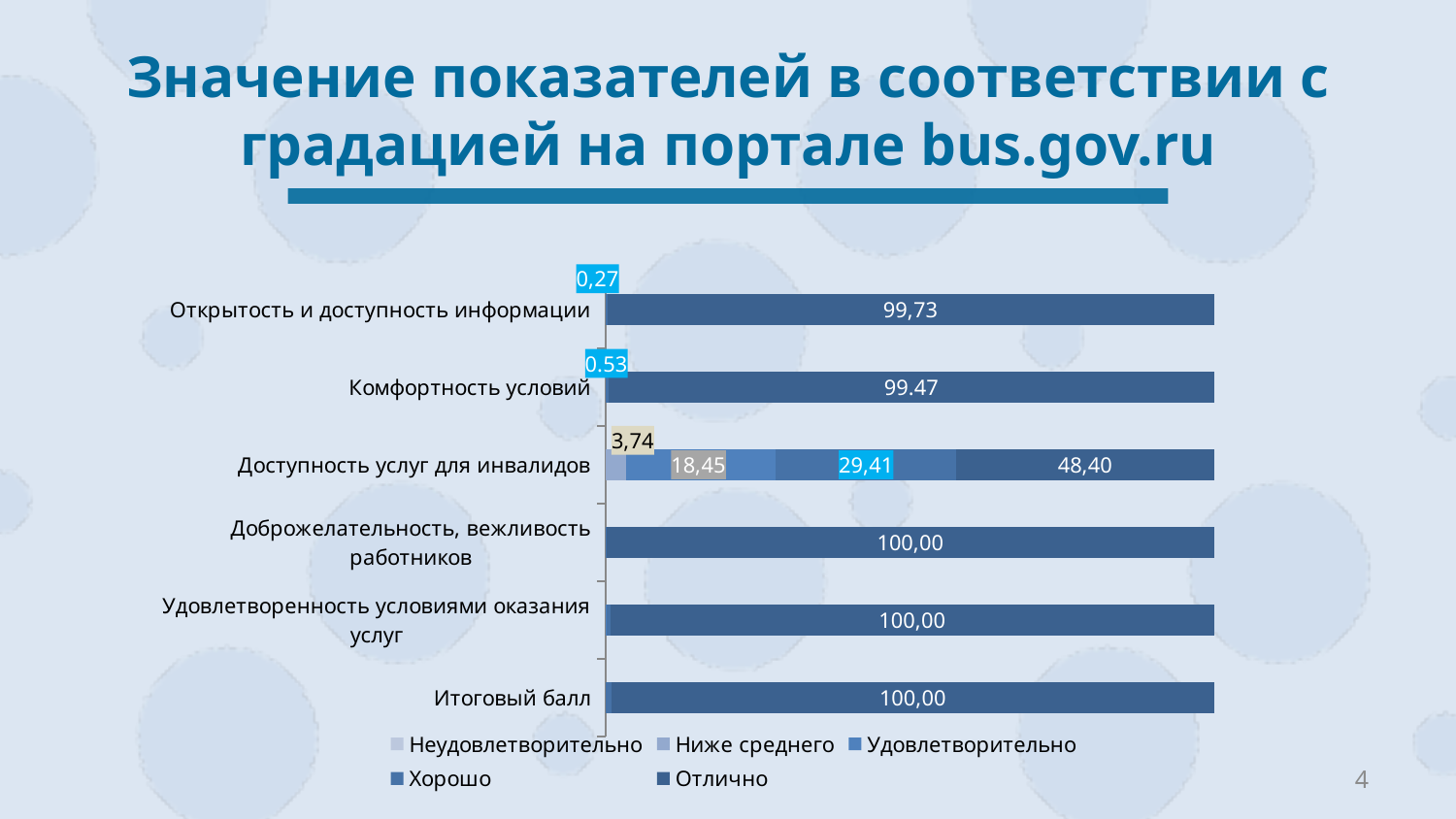
What is the total of the stacked bar for 'Доступность услуг для инвалидов'? 100,00 How many series does the legend list? 5 How many categories are plotted on the chart? 6 What is the value of the large segment for 'Открытость и доступность информации'? 99,73 In the bar for 'Доступность услуг для инвалидов', what is the difference between the 48,40 segment and the 29,41 segment? 18,99 What is the smallest segment value in the bar for 'Доступность услуг для инвалидов'? 3,74 Which category's bar is split into the most segments? Доступность услуг для инвалидов What kind of chart is shown on the slide? Stacked horizontal bar chart What is the value of the large segment for 'Комфортность условий'? 99.47 What is the first entry in the chart legend? Неудовлетворительно What value is shown for 'Доброжелательность, вежливость работников'? 100,00 What value is shown for 'Итоговый балл'? 100,00